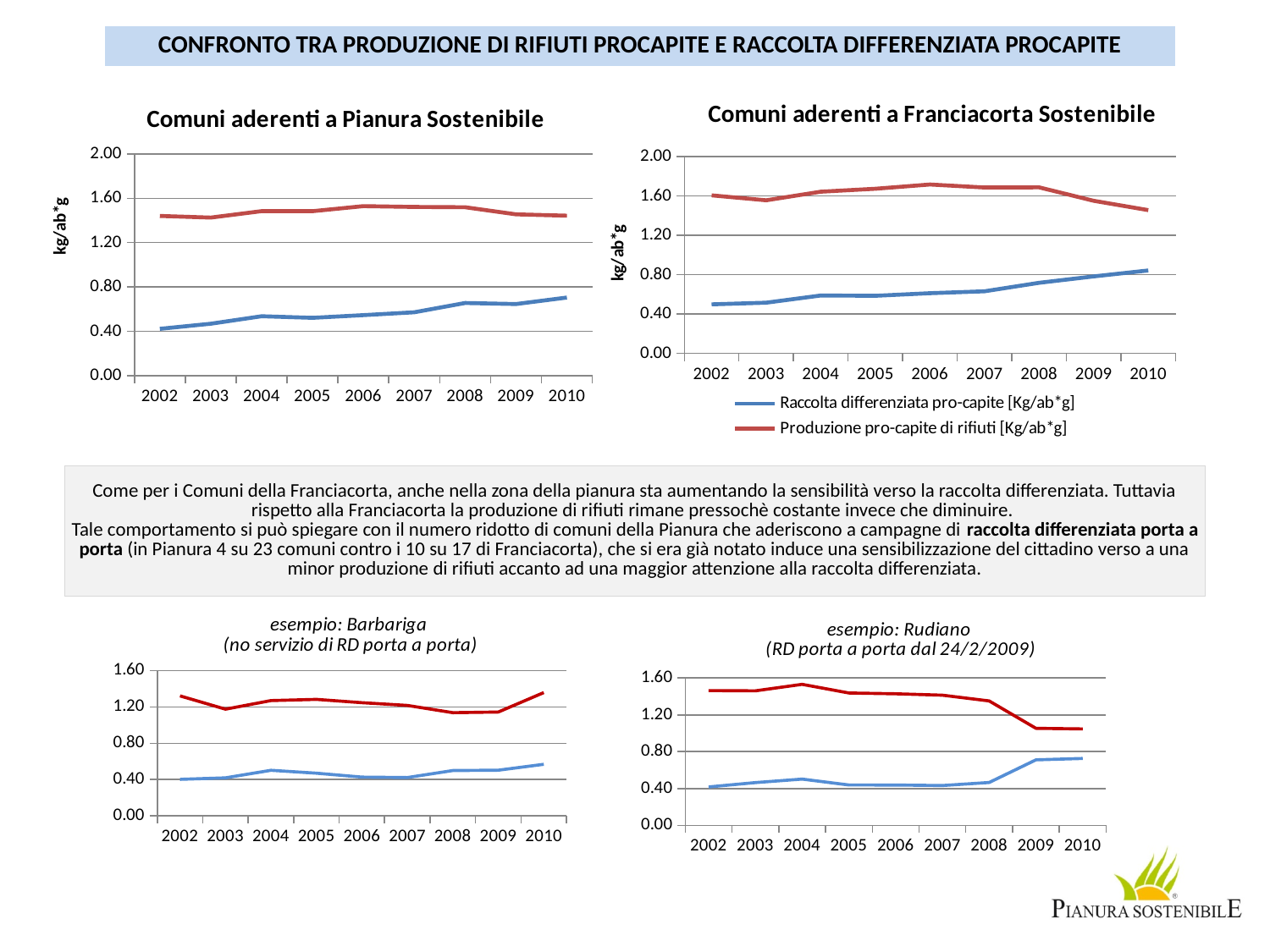
In the 'esempio: Rudiano' chart, does the red line rise or fall from 2008 to 2010? fall How many series does the legend of the 'Comuni aderenti a Franciacorta Sostenibile' chart list? 2 What is the y-axis label of the 'Comuni aderenti a Pianura Sostenibile' chart? kg/ab*g In the 'Comuni aderenti a Franciacorta Sostenibile' chart, in which year is Produzione pro-capite di rifiuti highest? 2006 In the 'esempio: Rudiano' chart, is the value of the red line in 2010 greater or less than 1.20? less In the 'Comuni aderenti a Franciacorta Sostenibile' chart, what is the legend entry for the blue line? Raccolta differenziata pro-capite [Kg/ab*g] In the 'Comuni aderenti a Pianura Sostenibile' chart, does the blue line (Raccolta differenziata pro-capite) rise or fall from 2002 to 2010? rise What kind of chart is 'Comuni aderenti a Pianura Sostenibile'? line chart In the 'Comuni aderenti a Pianura Sostenibile' chart, how many years are shown on the x axis? 9 In the 'Comuni aderenti a Pianura Sostenibile' chart, is the value of the blue line in 2002 greater or less than 0.80? less In the 'Comuni aderenti a Franciacorta Sostenibile' chart, is the value of Produzione pro-capite di rifiuti in 2006 greater or less than 1.60? greater In the 'esempio: Barbariga' chart, is the red line higher in 2009 or in 2010? 2010